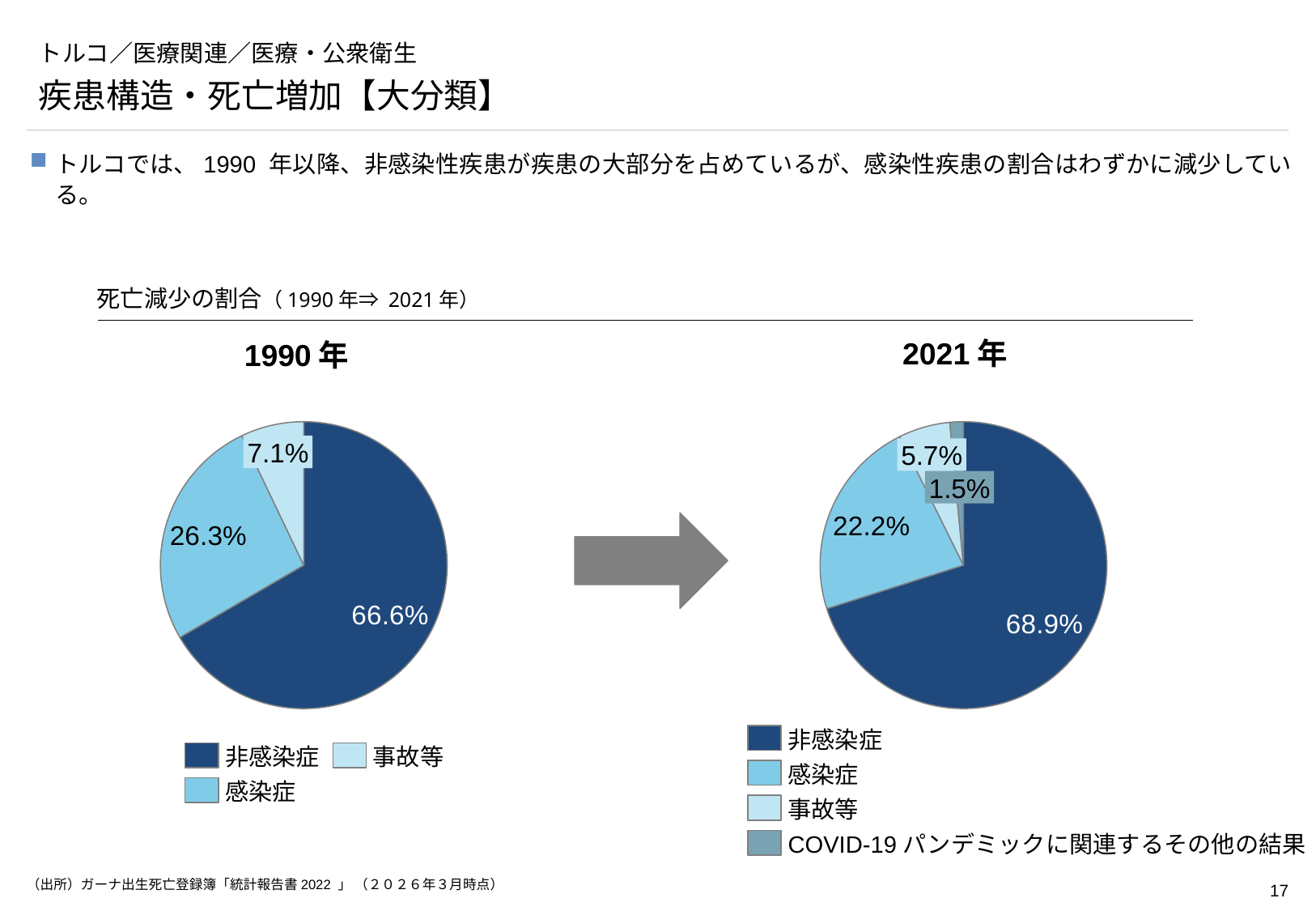
In the 2021年 pie chart, which category has the smallest share? COVID-19 パンデミックに関連するその他の結果 In the 1990年 pie chart, what is the share for 感染症? 26.3% In the 1990年 pie chart, what is the share for 非感染症? 66.6% What is the difference between the 感染症 share in the 1990年 chart and the 感染症 share in the 2021年 chart? 4.1 percentage points Which is larger: the 事故等 share in the 1990年 chart or the 事故等 share in the 2021年 chart? 1990年 (7.1%) How many categories does the 2021年 pie chart show? 4 In the 2021年 pie chart, what is the share for COVID-19 パンデミックに関連するその他の結果? 1.5% In the 1990年 pie chart, which category has the largest share? 非感染症 What type of chart is used for the 1990年 data? Pie chart In the 2021年 pie chart, what is the share for 非感染症? 68.9% How many entries does the legend of the 1990年 chart list? 3 In the 1990年 pie chart, what is the share for 事故等? 7.1%